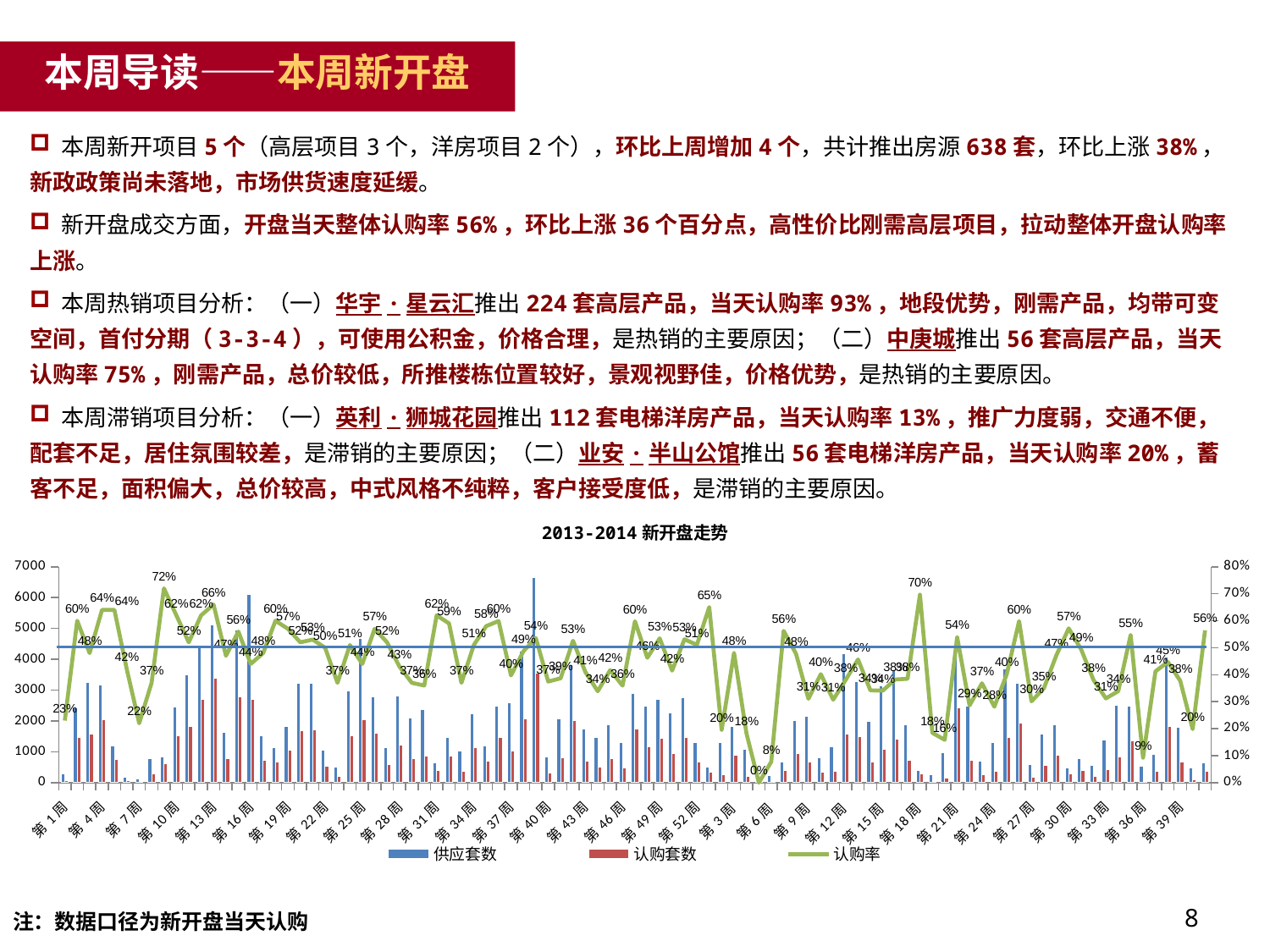
What is the maximum value shown on the right-hand percentage axis? 80% What is the last 认购率 value labeled at the right end of the line? 56% Is the tallest 供应套数 bar greater or less than 6000? greater Which series is drawn as a line rather than bars? 认购率 What is the title of the chart on the slide? 2013-2014 新开盘走势 What is the first 认购率 value labeled at the left end of the line (第1周)? 23% What is the lowest 认购率 value labeled on the line? 0% How many series does the chart's legend list? 3 What kind of chart is shown on the slide? A combined bar and line chart What is the highest 认购率 value labeled on the line? 72% Which series generally has taller bars, 供应套数 or 认购套数? 供应套数 What is the difference between the highest (72%) and lowest (0%) labeled 认购率 values? 72 percentage points